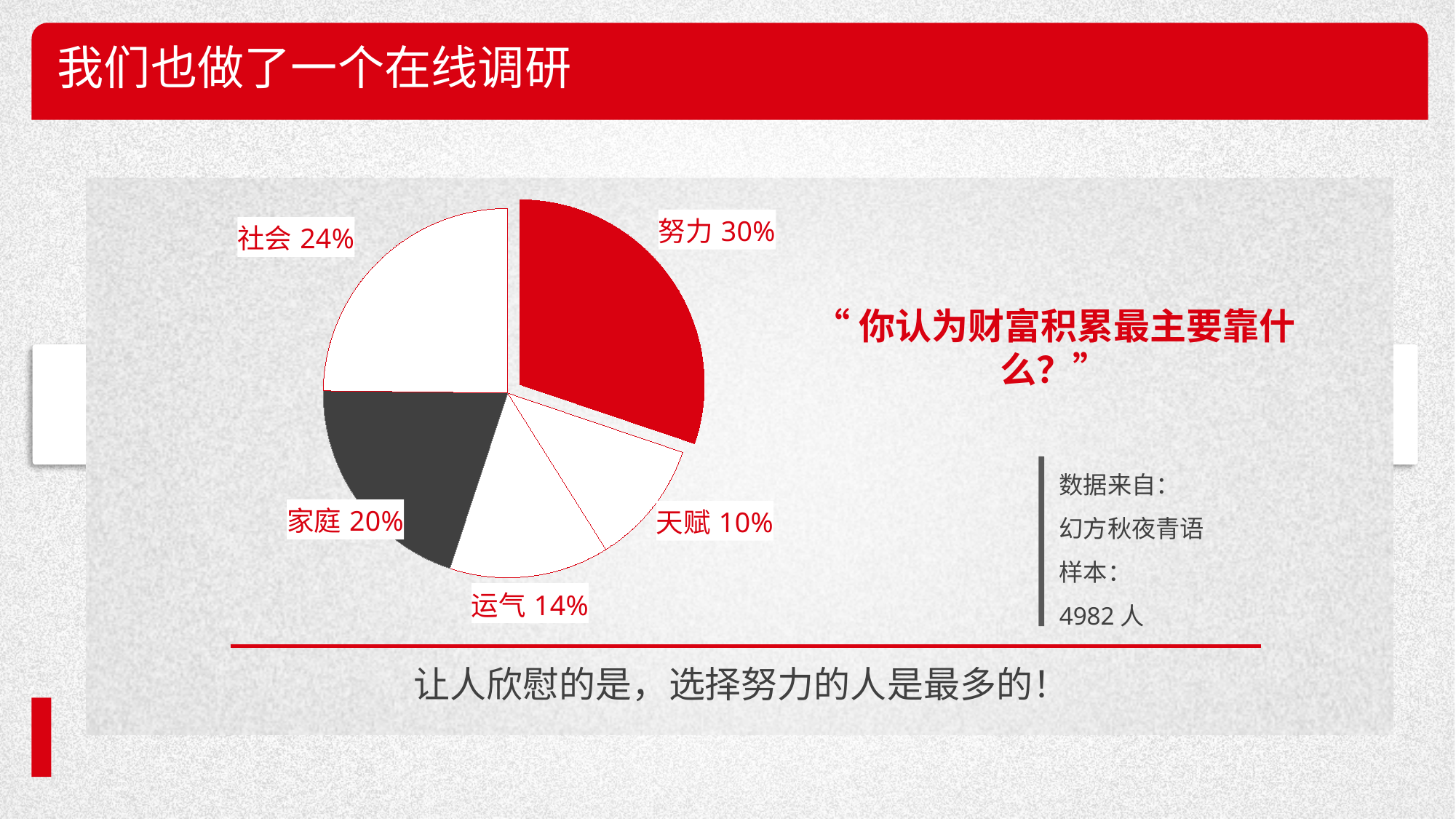
What kind of chart is shown on the slide? pie chart Which category has the smallest share of the pie? 天赋 Which slice of the pie is coloured red? 努力 What percentage of respondents chose 运气 (luck)? 14% How many categories are shown in the pie chart? 5 What percentage of respondents chose 社会 (society)? 24% What percentage of respondents chose 天赋 (talent)? 10% What percentage of respondents chose 努力 (effort)? 30% What percentage of respondents chose 家庭 (family)? 20% What is the difference in percentage points between 努力 and 天赋? 20 Which is larger, the share for 社会 or the share for 家庭? 社会 Which category has the largest share of the pie? 努力